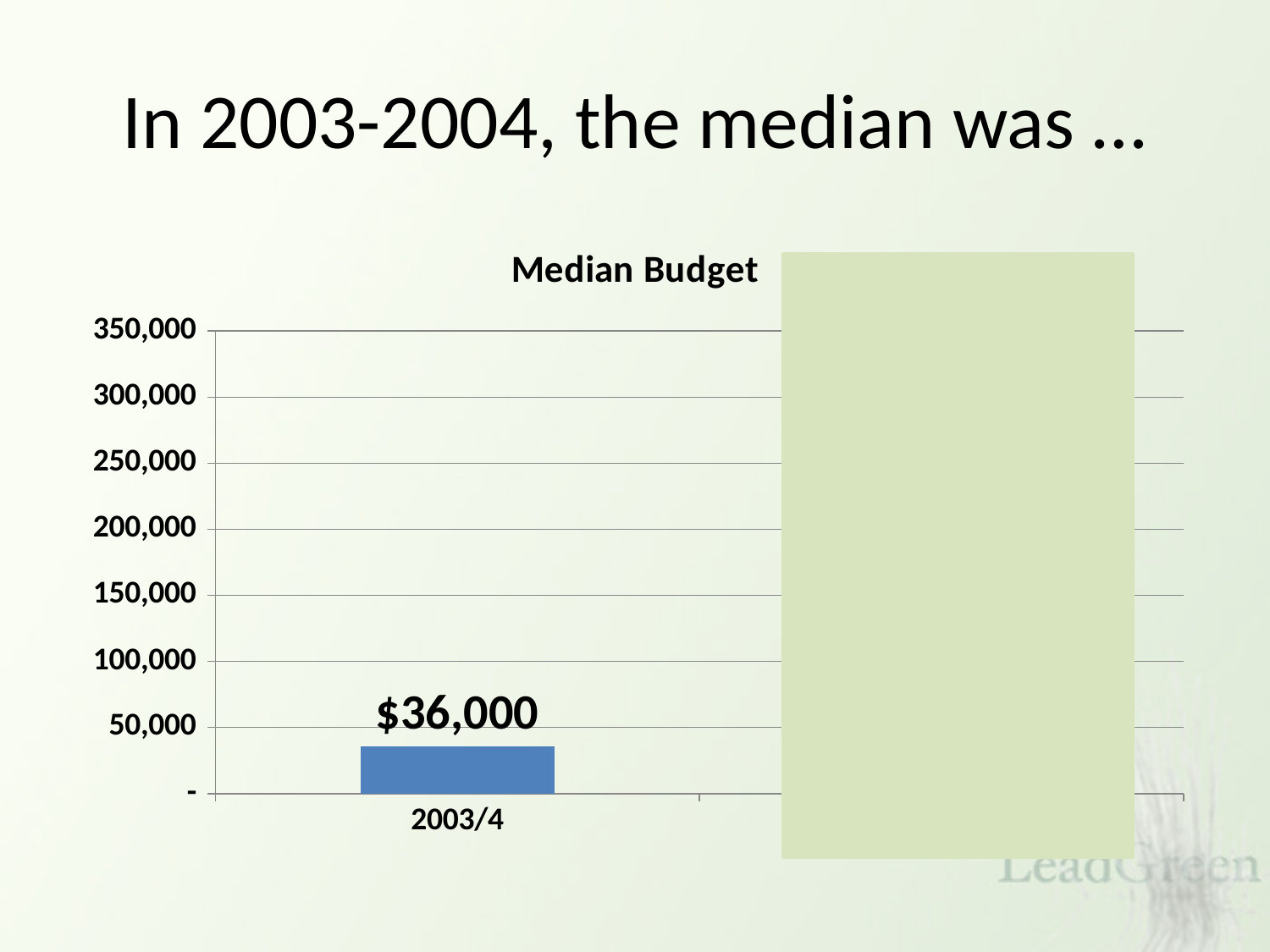
What is the median budget value shown for 2003/4? $36,000 How many bars are visible on the chart? 1 Which category label is shown on the x axis of the chart? 2003/4 Is the value for 2003/4 greater or less than 100,000? less What kind of chart is shown on the slide? bar chart Is the value for 2003/4 greater or less than 50,000? less What is the title of the chart? Median Budget What is the highest value shown on the vertical axis? 350,000